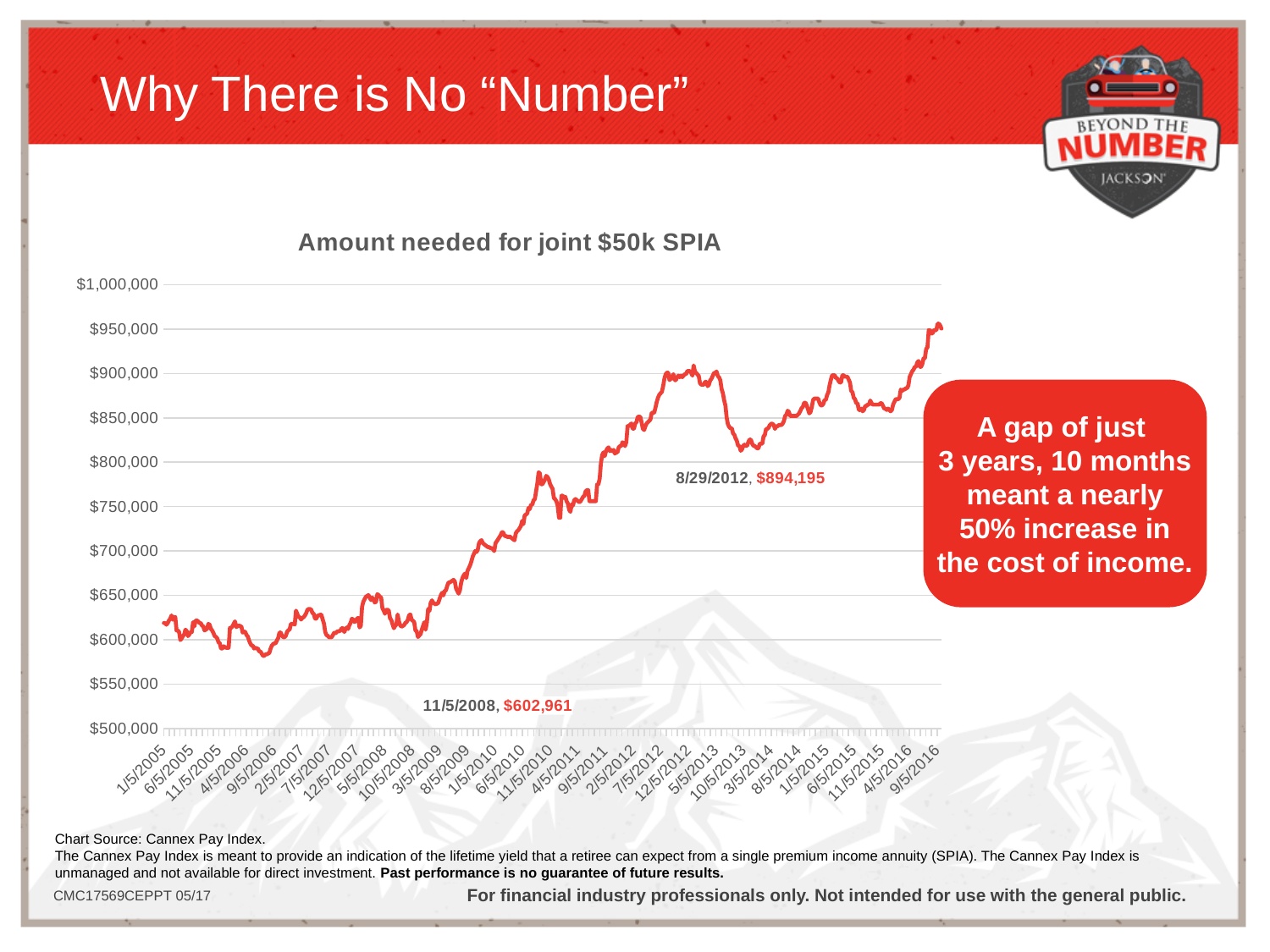
Which labelled date has the larger value, 11/5/2008 or 8/29/2012? 8/29/2012 What is the title of the chart? Amount needed for joint $50k SPIA Is the value at 9/5/2016 greater or less than $900,000? greater Is the value at 7/5/2012 greater or less than $850,000? greater How many lines are plotted on the chart? 1 What is the difference between the labelled values for 8/29/2012 and 11/5/2008? $291,234 Overall, does the amount needed rise or fall from 1/5/2005 to 9/5/2016? rise What kind of chart is shown on the slide? line chart What is the highest value shown on the vertical axis? $1,000,000 What value is labelled on the chart for 11/5/2008? $602,961 What value is labelled on the chart for 8/29/2012? $894,195 Is the value at 1/5/2005 greater or less than $650,000? less